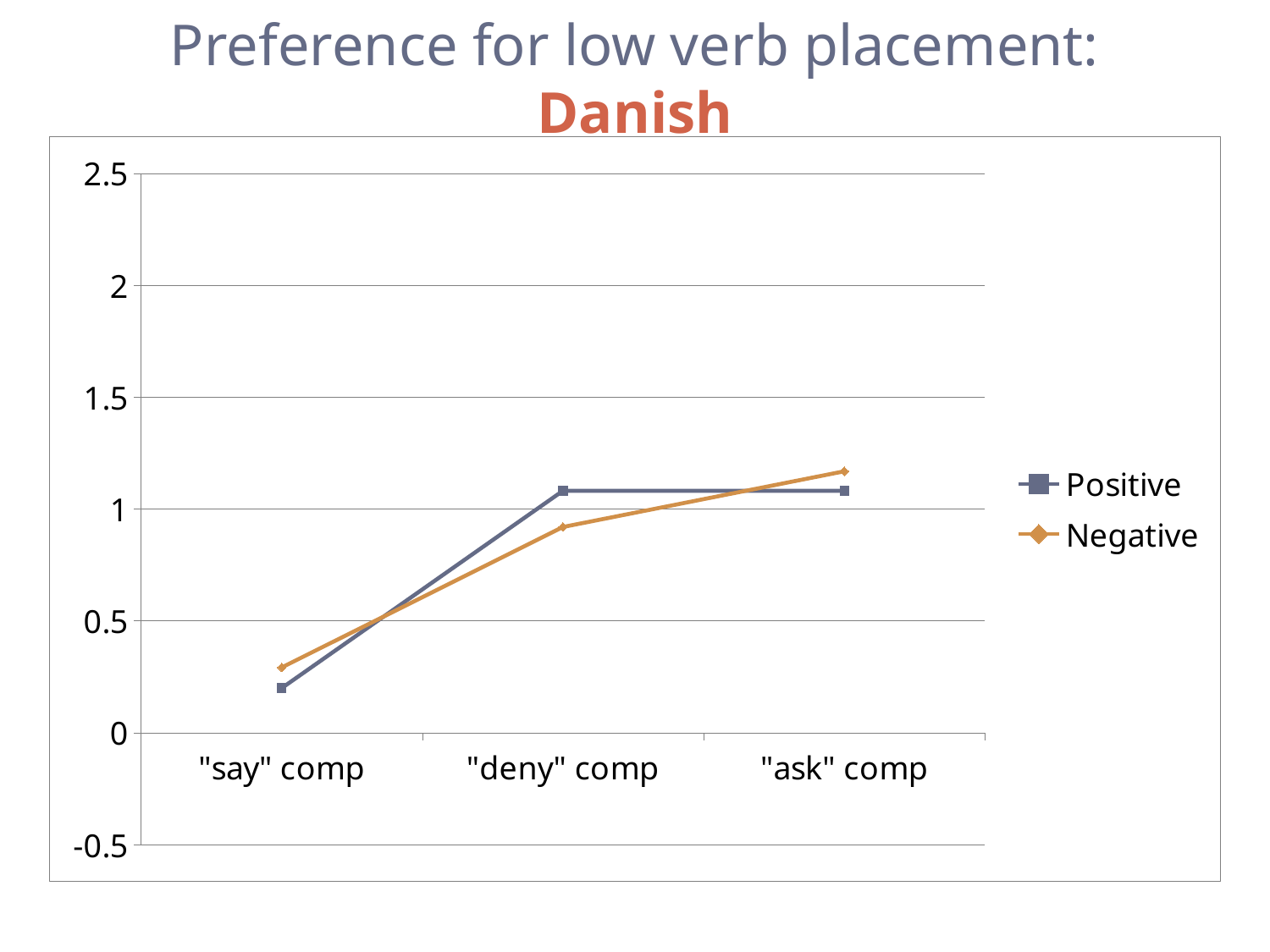
How many categories are shown on the x axis? 3 How many series does the legend list? 2 Is the Positive value for "deny" comp greater or less than 0.5? greater Is the Negative value for "say" comp greater or less than 0.5? less What is the title of the chart? Preference for low verb placement: Danish Is the Negative value for "ask" comp greater or less than 1? greater At "say" comp, which series has the higher value, Positive or Negative? Negative Does the Negative series rise or fall from "say" comp to "ask" comp? rise At "deny" comp, which series has the higher value, Positive or Negative? Positive Which series are listed in the legend? Positive and Negative What kind of chart is shown on the slide? line chart